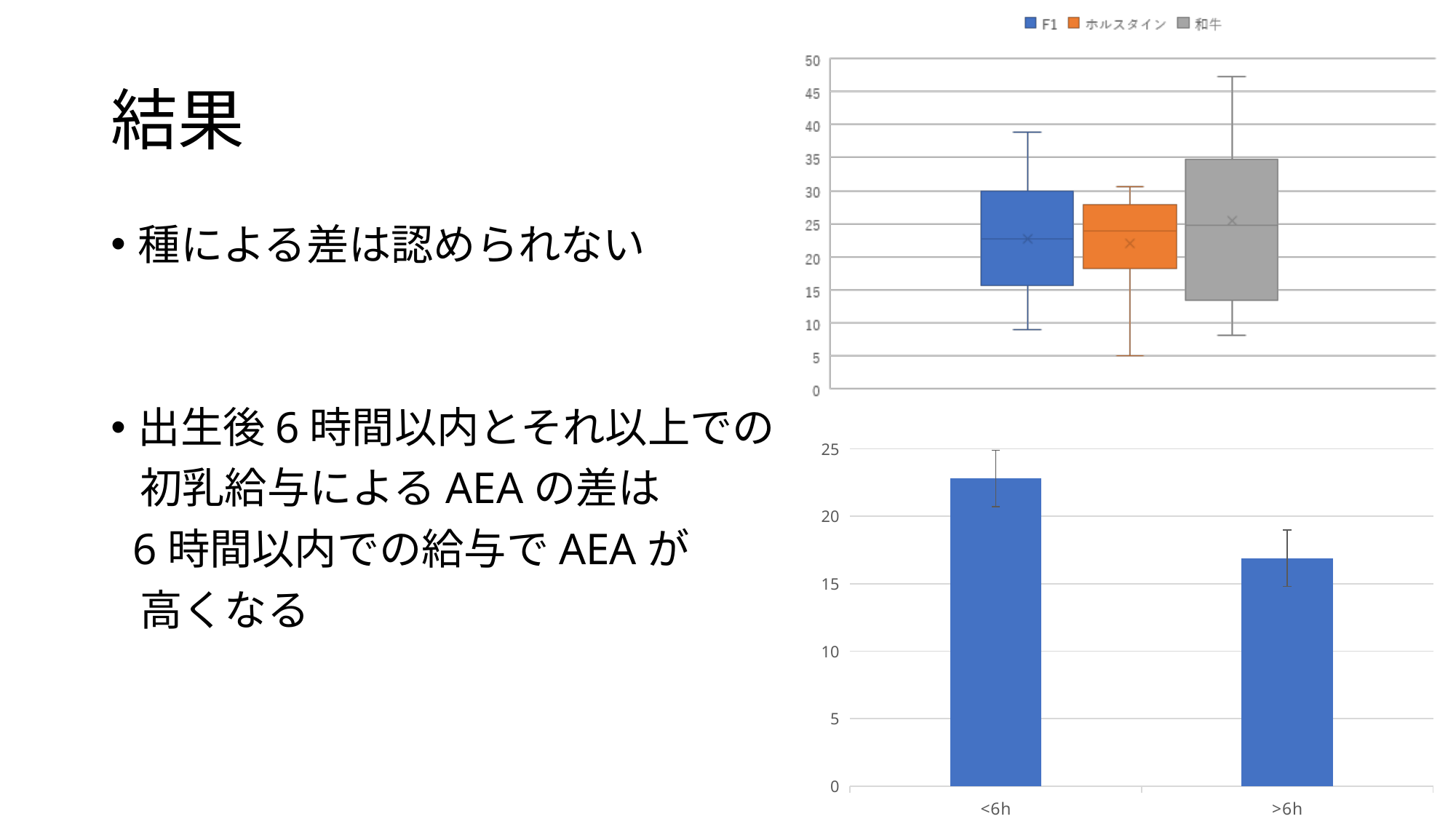
In the bottom chart, is the value for >6h greater or less than 20? less In the bottom chart, which category has the higher bar, <6h or >6h? <6h What kind of chart is the bottom chart on the slide? bar chart What kind of chart is the top chart on the slide? box-and-whisker chart In the top chart, which series has the lowest lower whisker? ホルスタイン In the top chart, which series has the highest upper whisker? 和牛 In the bottom chart, is the value for <6h greater or less than 20? greater In the bottom chart, how many categories are shown on the x axis? 2 In the bottom chart, do the bar values rise or fall from <6h to >6h? fall In the bottom chart, which category has the highest value? <6h In the top chart, what colour represents the 和牛 series? grey In the top chart, how many series does the legend list? 3